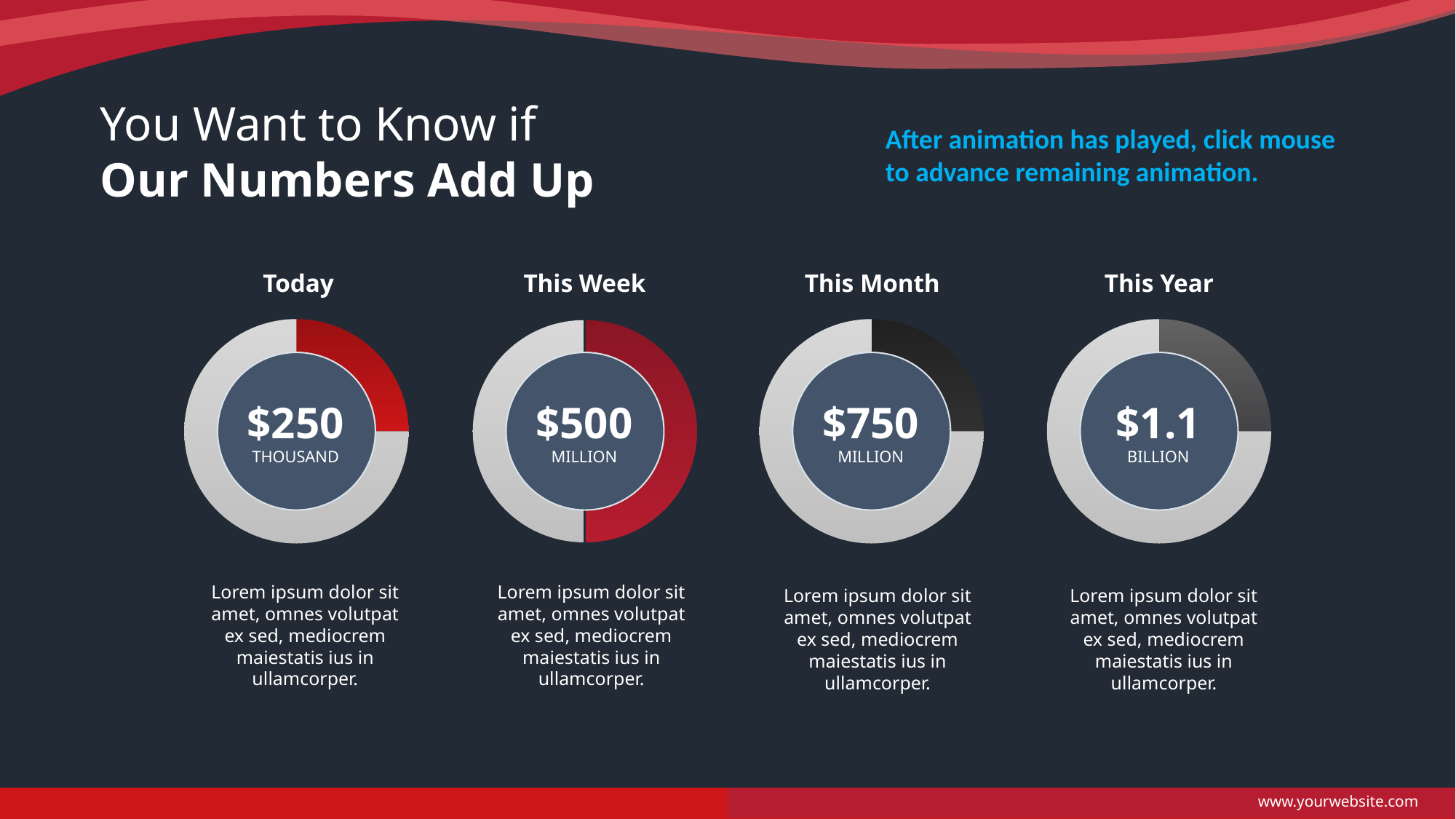
What value is shown in the centre of the "This Month" donut chart? $750 MILLION What kind of chart is used for each of the four figures on the slide? Donut chart Is the filled portion of the "This Week" donut ring greater or less than 25%? greater Is the filled portion of the "This Week" donut chart larger or smaller than that of the "Today" donut chart? Larger How many donut charts are shown on the slide? 4 What colour is the filled segment of the "This Month" donut chart? Black Which of the four donut charts has the largest filled portion of its ring? This Week What value is shown in the centre of the "Today" donut chart? $250 THOUSAND What colour is the filled segment of the "Today" donut chart? Red Is the filled portion of the "Today" donut ring greater or less than 50%? less What value is shown in the centre of the "This Year" donut chart? $1.1 BILLION What value is shown in the centre of the "This Week" donut chart? $500 MILLION